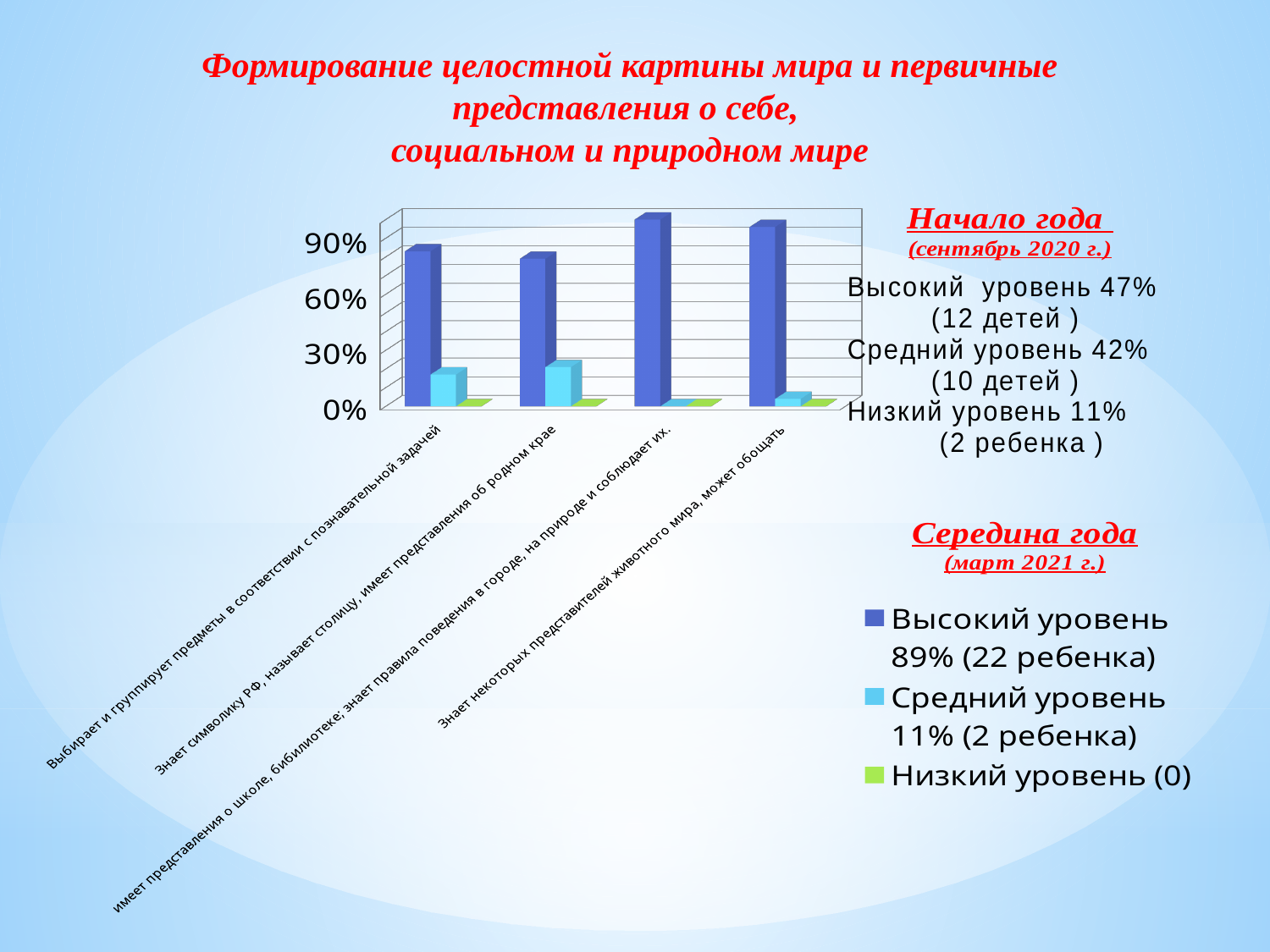
How many series does the chart's legend list? 3 Which colour represents Низкий уровень in the chart's legend? green Is the value of Высокий уровень for the category 'Выбирает и группирует предметы в соответствии с познавательной задачей' greater or less than 60%? greater Which is larger: the Средний уровень value for 'Знает символику РФ, называет столицу, имеет представления об родном крае' or for 'Знает некоторых представителей животного мира, может обощать'? Знает символику РФ, называет столицу, имеет представления об родном крае According to the chart's legend, what percentage and number of children are given for Высокий уровень? 89% (22 ребенка) How many categories are shown along the x axis of the chart? 4 Which category has the highest Высокий уровень bar? имеет представления о школе, библиотеке; знает правила поведения в городе, на природе и соблюдает их. Is the value of Средний уровень for the category 'Знает символику РФ, называет столицу, имеет представления об родном крае' greater or less than 30%? less What kind of chart is shown on the slide? bar chart Which category has the highest Средний уровень bar? Знает символику РФ, называет столицу, имеет представления об родном крае Which is larger: the Высокий уровень value for 'Выбирает и группирует предметы в соответствии с познавательной задачей' or for 'Знает символику РФ, называет столицу, имеет представления об родном крае'? Выбирает и группирует предметы в соответствии с познавательной задачей Is the value of Высокий уровень for the category 'имеет представления о школе, библиотеке; знает правила поведения в городе, на природе и соблюдает их.' greater or less than 90%? greater